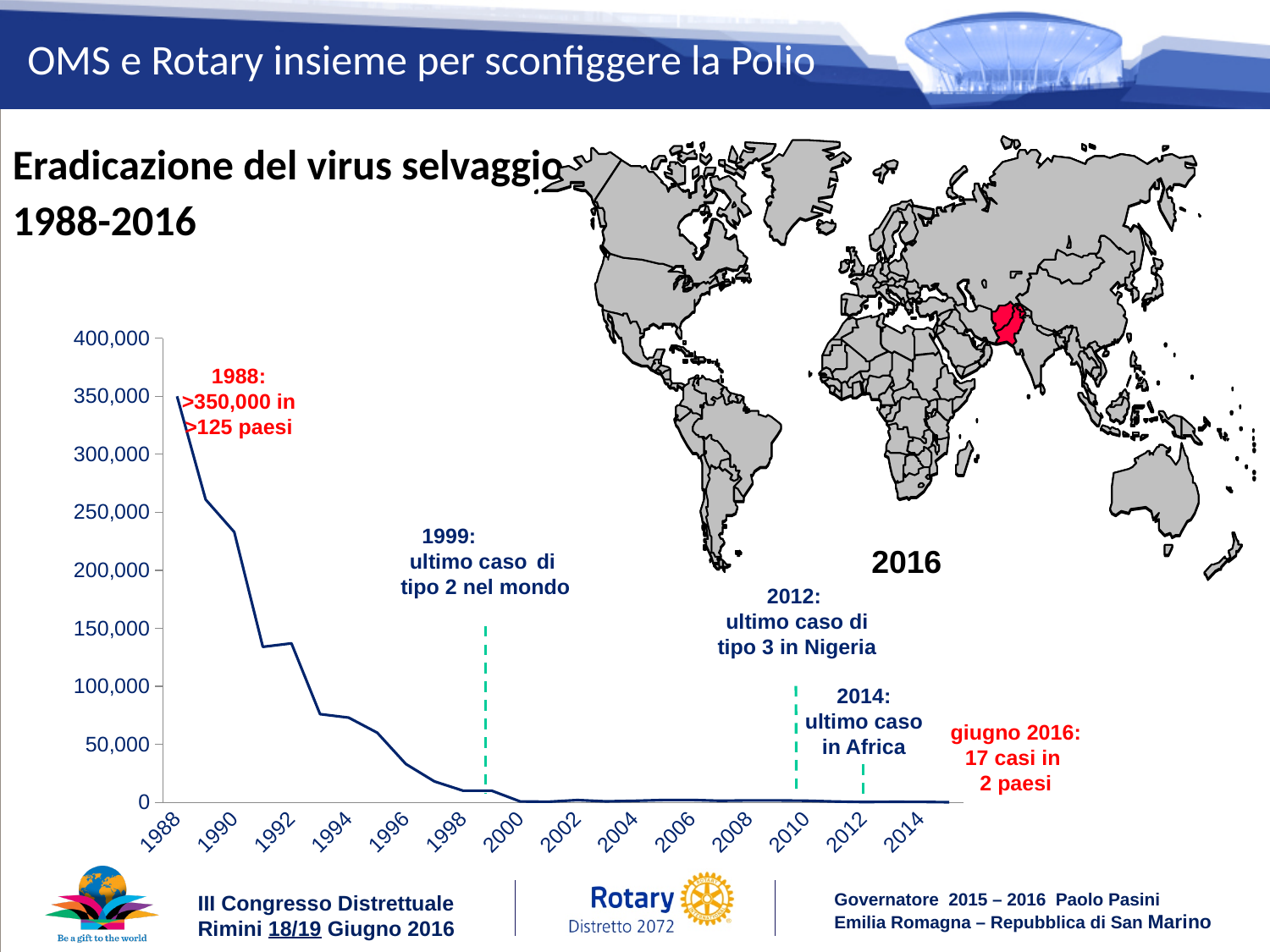
Is the value for 1996 greater or less than 50,000? less What kind of chart is shown on the slide? line chart Which year has the larger value, 1992 or 1998? 1992 Which year on the x axis has the highest value in the chart? 1988 Is the value for 1990 greater or less than 300,000? less What is the title of the chart on the slide? Eradicazione del virus selvaggio 1988-2016 Is the value for 2000 greater or less than 50,000? less Which year has the larger value, 1988 or 1994? 1988 Do the values in the chart rise or fall from 1988 to 2014? fall How many year labels are shown on the x axis of the chart? 14